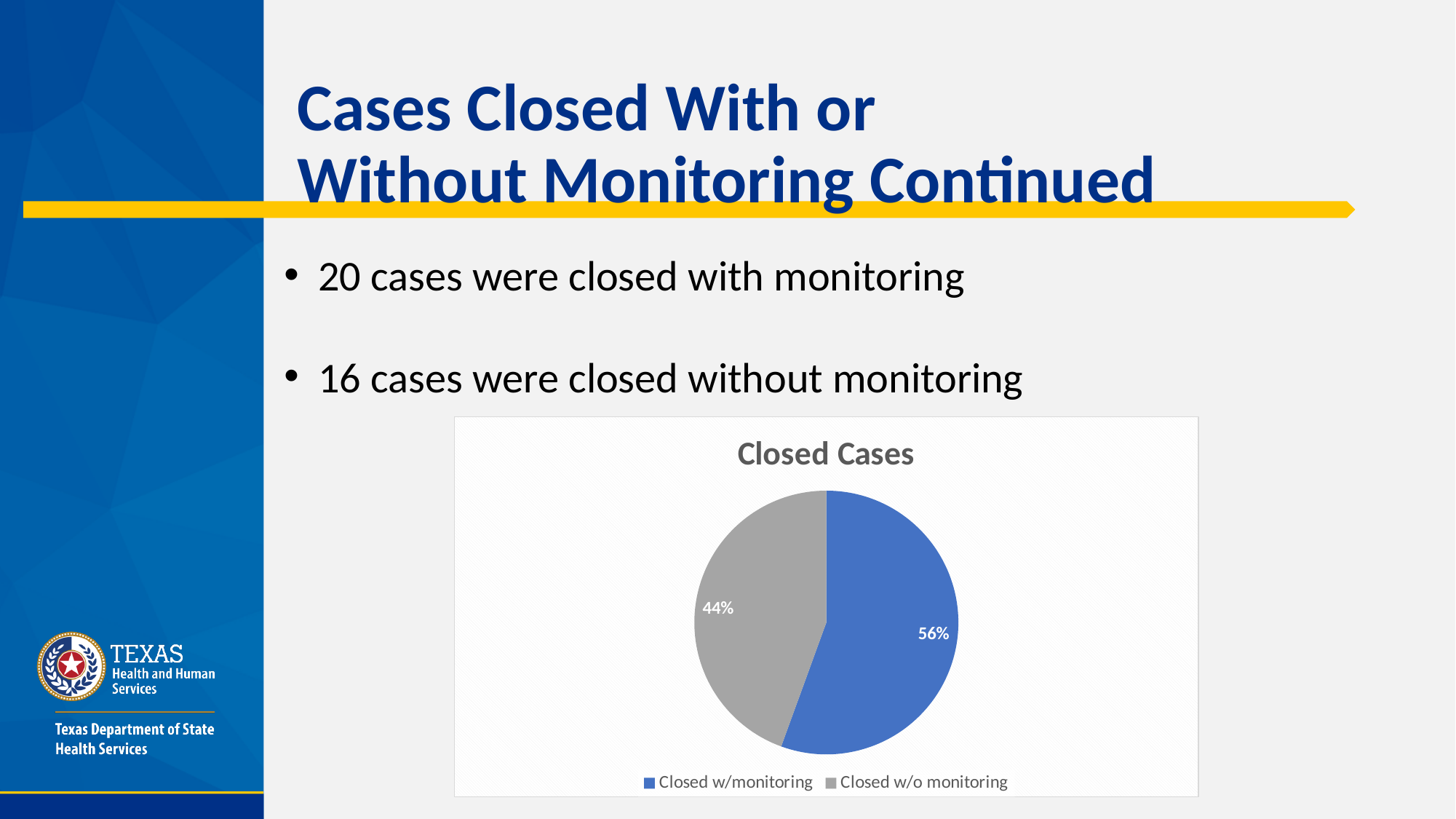
What is the title of the chart? Closed Cases Which slice of the pie is the largest? Closed w/monitoring What share of the pie is labelled for Closed w/o monitoring? 44% Which is larger, the share for Closed w/monitoring or the share for Closed w/o monitoring? Closed w/monitoring What kind of chart is shown on the slide? pie chart What colour is the Closed w/o monitoring slice? grey How many entries does the legend list? 2 Which slice of the pie is the smallest? Closed w/o monitoring What is the difference in percentage points between the Closed w/monitoring slice and the Closed w/o monitoring slice? 12 What share of the pie is labelled for Closed w/monitoring? 56% How many slices does the pie chart have? 2